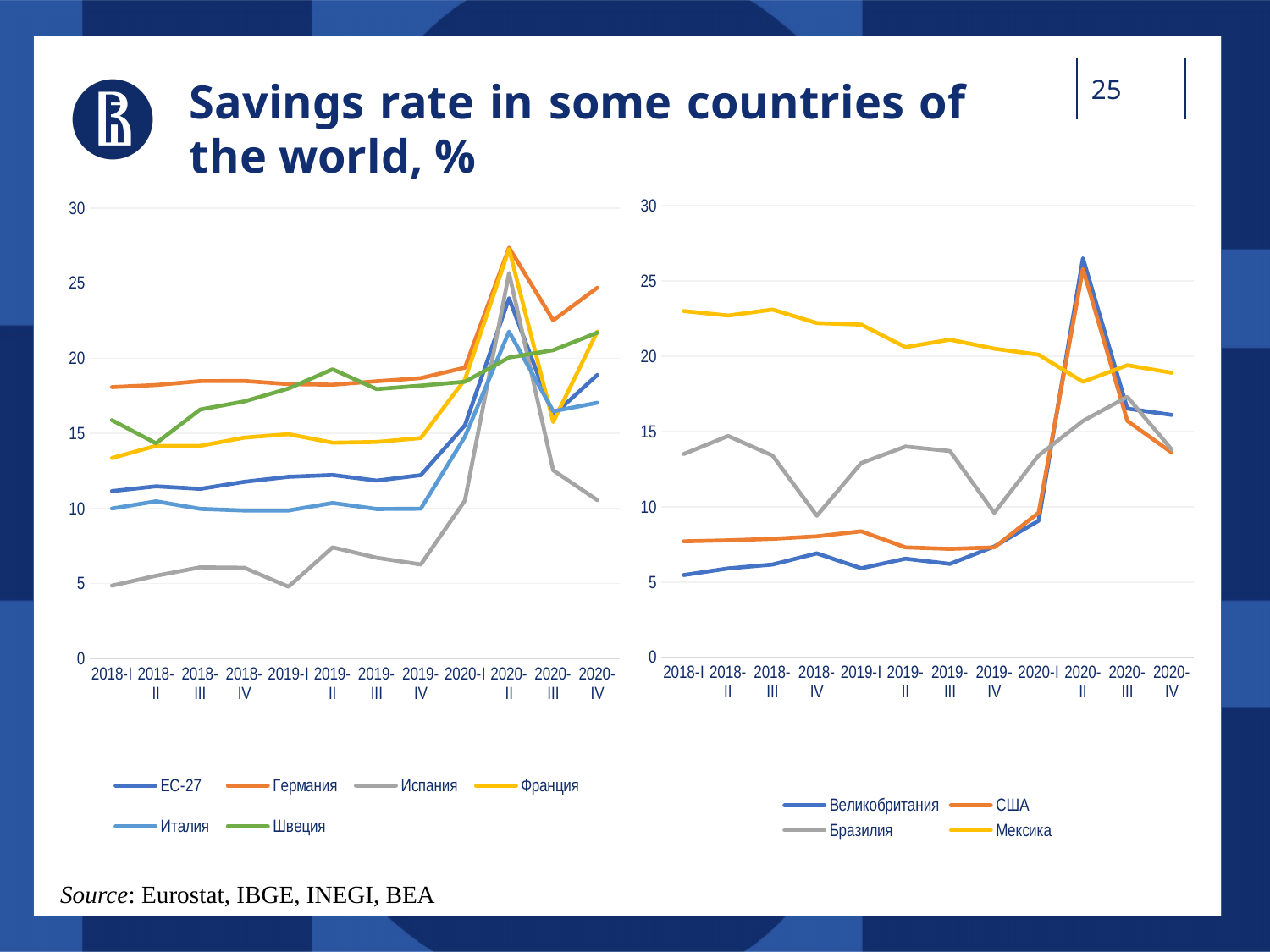
How many quarters are shown along the x axis of the right chart? 12 In the left chart, which series has the lowest value at 2018-I? Испания In the left chart, which series has the highest value at 2018-I? Германия What kind of chart is the left chart on the slide? Line chart In the right chart, which is larger at 2020-IV: Мексика or США? Мексика How many series does the legend of the left chart list? 6 In the right chart, is the value for Бразилия at 2018-IV greater or less than 10? less In the right chart, does the value for Мексика rise or fall from 2018-I to 2020-II? fall In the right chart, is the value for Мексика at 2018-I greater or less than 20? greater How many series does the legend of the right chart list? 4 In the right chart, which series has the highest value at 2018-I? Мексика In the right chart, which series has the lowest value at 2018-I? Великобритания